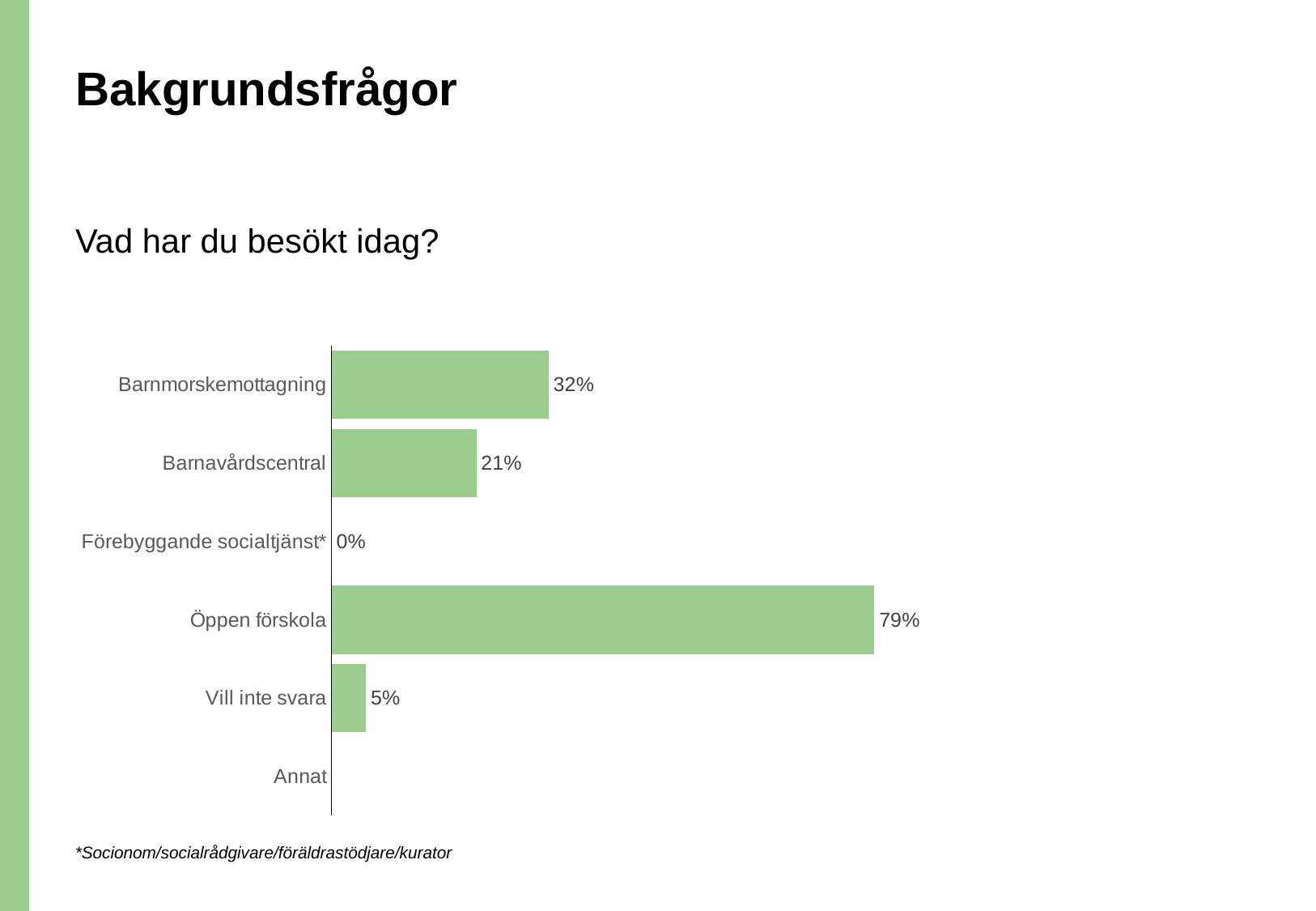
What kind of chart is shown on the slide? Bar chart What question does the chart answer, as written above it? Vad har du besökt idag? What is the value for Barnmorskemottagning? 32% How many categories are listed on the chart's axis? 6 Which is larger, the value for Barnavårdscentral or the value for Vill inte svara? Barnavårdscentral What is the value for Barnavårdscentral? 21% Which category has the highest value? Öppen förskola What is the value for Öppen förskola? 79% What is the value for Förebyggande socialtjänst*? 0% What is the value for Vill inte svara? 5% What is the difference between the values for Öppen förskola and Barnmorskemottagning? 47% What is the difference between the values for Barnmorskemottagning and Barnavårdscentral? 11%